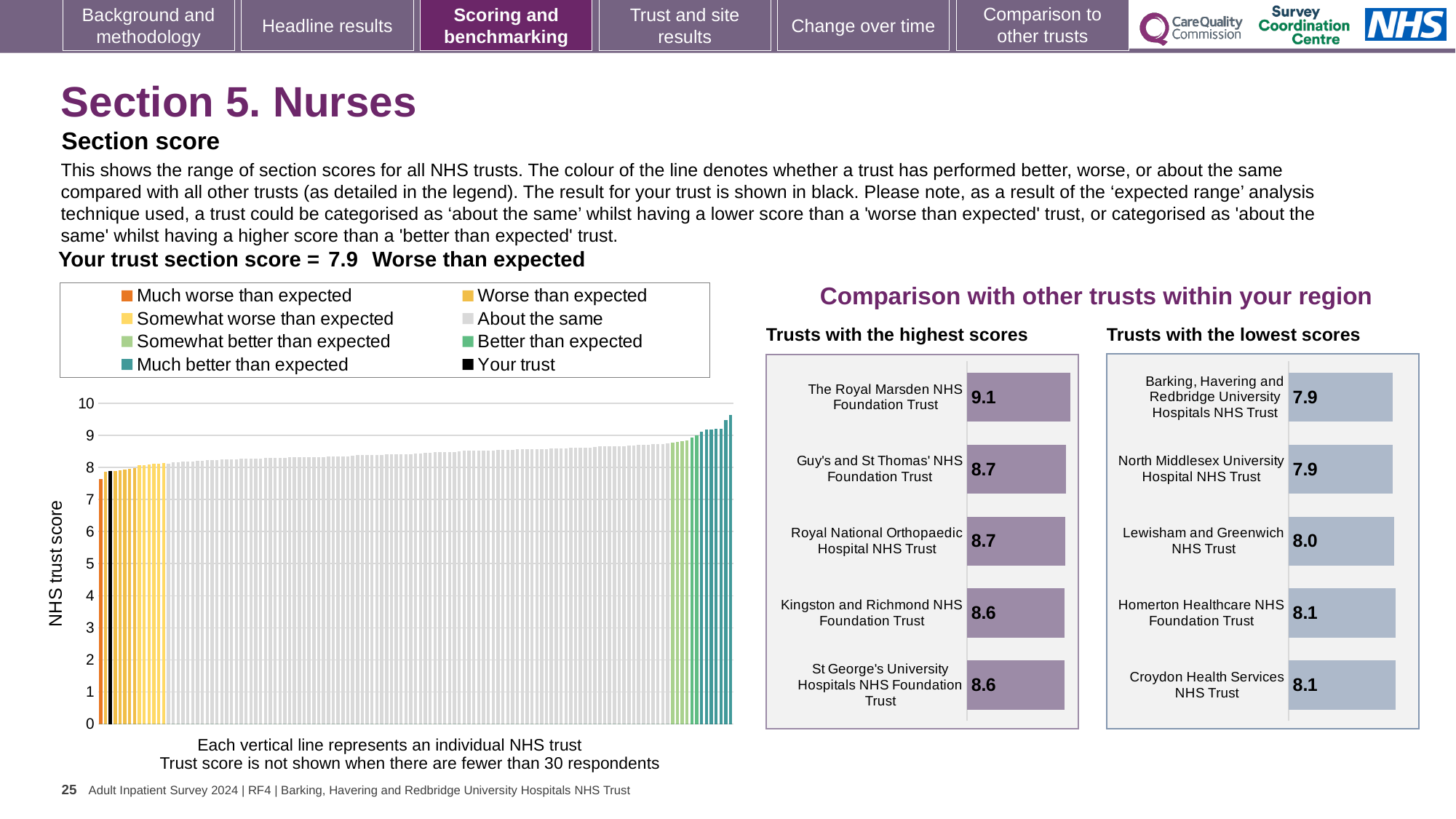
In the 'Trusts with the highest scores' chart, which has the larger score: The Royal Marsden NHS Foundation Trust or Guy's and St Thomas' NHS Foundation Trust? The Royal Marsden NHS Foundation Trust In the left-hand NHS trust score chart, is the value of the tallest bar greater or less than 9? greater What kind of chart is the large chart on the left showing NHS trust scores? Bar chart In the 'Trusts with the highest scores' chart, which trust has the highest score? The Royal Marsden NHS Foundation Trust What is the title above the two smaller charts on the right of the slide? Comparison with other trusts within your region In the 'Trusts with the lowest scores' chart, what is the difference between the scores of Croydon Health Services NHS Trust and Barking, Havering and Redbridge University Hospitals NHS Trust? 0.2 In the left-hand NHS trust score chart, do the values rise or fall from left to right along the x axis? Rise In the 'Trusts with the highest scores' chart, what is the score for The Royal Marsden NHS Foundation Trust? 9.1 How many trusts are shown in the 'Trusts with the highest scores' chart? 5 In the 'Trusts with the highest scores' chart, what is the difference between the scores of The Royal Marsden NHS Foundation Trust and Kingston and Richmond NHS Foundation Trust? 0.5 In the 'Trusts with the lowest scores' chart, what is the score for Lewisham and Greenwich NHS Trust? 8.0 How many entries does the legend of the left-hand NHS trust score chart list? 8